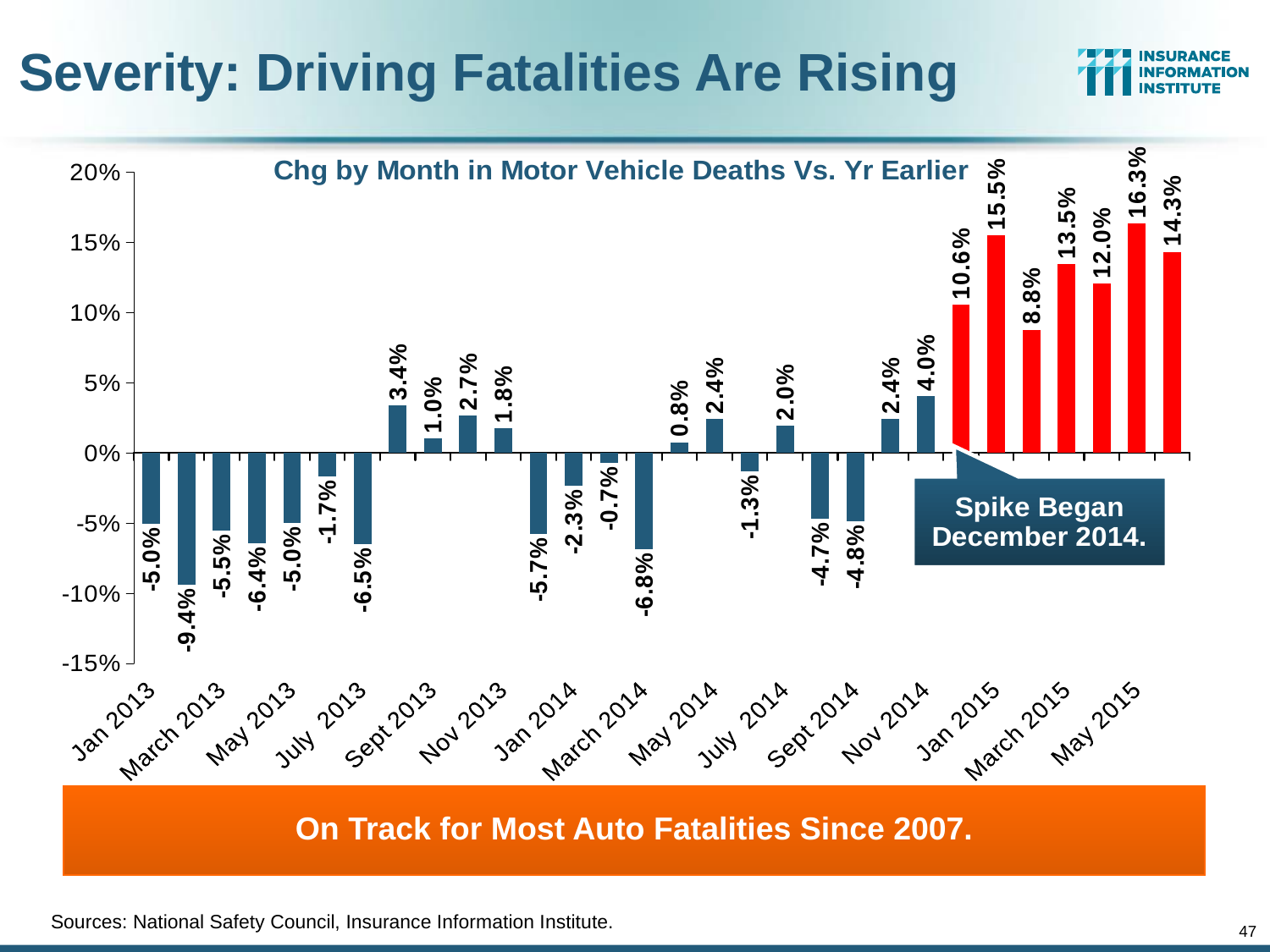
What is the title of the chart? Chg by Month in Motor Vehicle Deaths Vs. Yr Earlier What is the value for Jan 2013? -5.0% Do the values rise or fall from Sept 2014 to Jan 2015? Rise What kind of chart is shown on the slide? Bar chart What is the difference between the values for May 2015 and Jan 2015? 0.8 percentage points Which labeled month has the highest value? May 2015 What is the lowest value shown on the chart? -9.4% What is the value for Nov 2014? 4.0% What is the value for Jan 2015? 15.5% Is the value for Sept 2013 greater or less than 5%? less What is the value for March 2014? -6.8% Which is larger, the value for Jan 2015 or the value for March 2015? Jan 2015